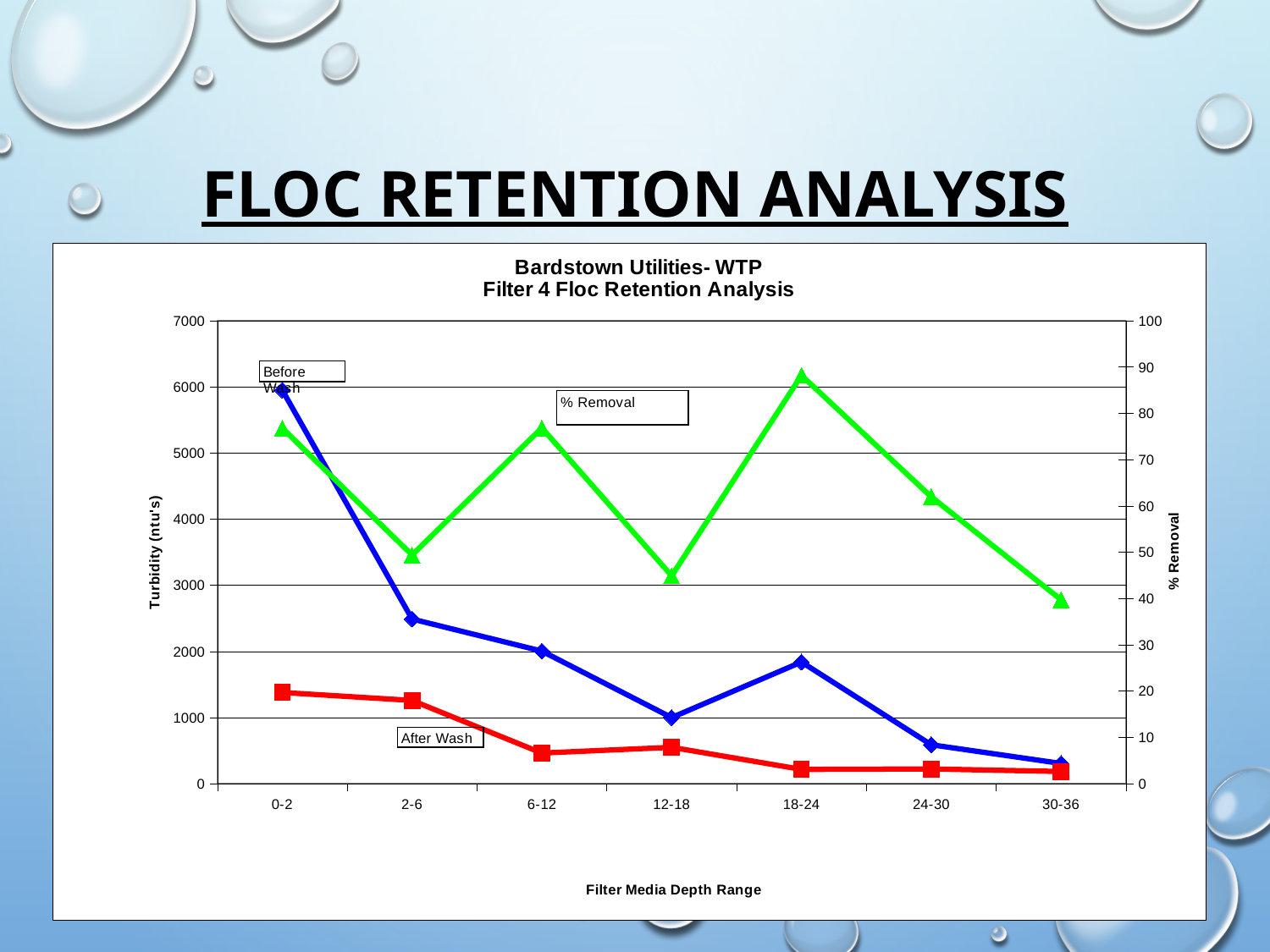
At which filter media depth range is the % Removal highest? 18-24 How many filter media depth ranges are shown on the x axis? 7 Is the Before Wash turbidity at 0-2 greater or less than 5000? greater Which is larger at the 6-12 depth range, the Before Wash turbidity or the After Wash turbidity? Before Wash Does the After Wash turbidity generally rise or fall as the filter media depth range increases? Fall What is the label of the x axis? Filter Media Depth Range At which filter media depth range is the % Removal lowest? 30-36 At which filter media depth range is the Before Wash turbidity highest? 0-2 Is the Before Wash turbidity at 2-6 greater or less than 3000? less Is the % Removal at 30-36 greater or less than 50? less How many data series are plotted on the chart? 3 What kind of chart is shown on the slide? Line chart